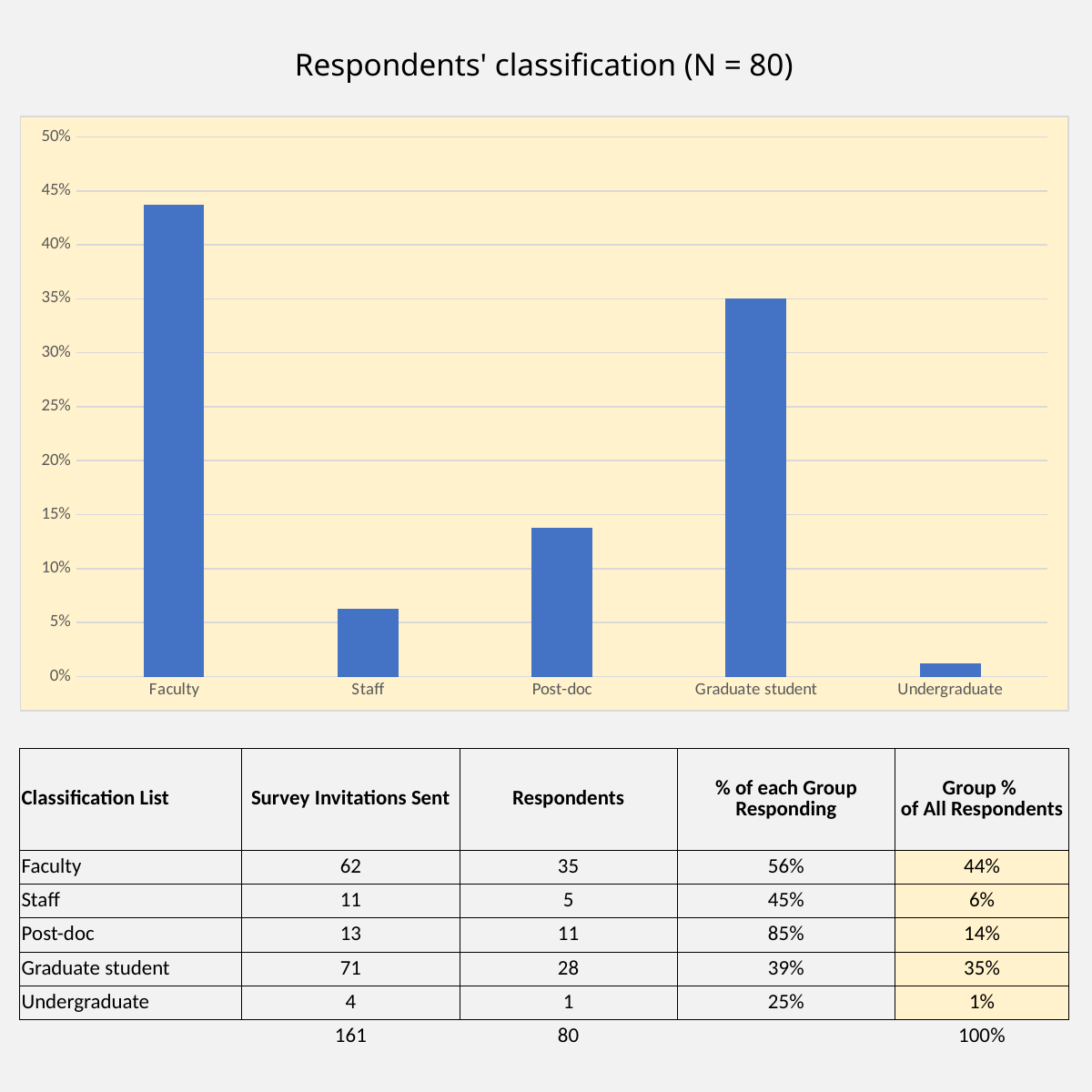
What is the value plotted for Faculty, as given in the table's 'Group % of All Respondents' column? 44% Is the value for Staff greater or less than 10%? less Which category has the lowest bar in the chart? Undergraduate Using the table values, what is the difference between the Faculty and Graduate student percentages of all respondents? 9% What kind of chart is shown on the slide? bar chart Which category has the highest bar in the chart? Faculty Which is larger, the bar for Post-doc or the bar for Staff? Post-doc Is the value for Graduate student greater or less than 30%? greater What is the title of the chart? Respondents' classification (N = 80) How many categories are plotted in the chart? 5 What is the value plotted for Graduate student, as given in the table's 'Group % of All Respondents' column? 35% What is the value plotted for Post-doc, as given in the table's 'Group % of All Respondents' column? 14%